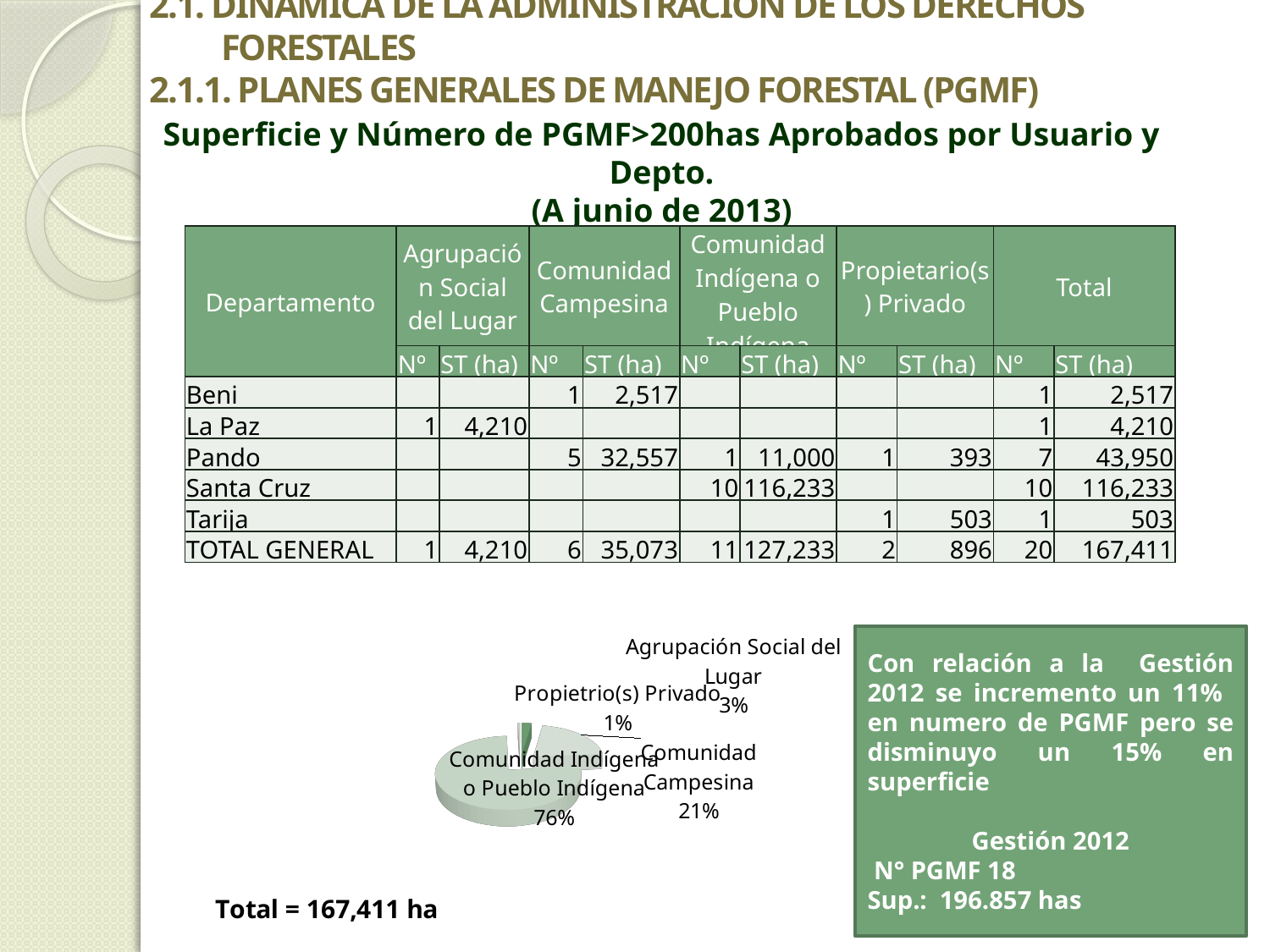
What kind of chart is shown at the bottom of the slide? pie chart In the pie chart, what share does Propietrio(s) Privado have? 1% Is the share for Comunidad Campesina greater or less than 50%? less In the pie chart, which is larger: Comunidad Campesina or Agrupación Social del Lugar? Comunidad Campesina How many slices does the pie chart have? 4 What is the difference in percentage points between the Comunidad Indígena o Pueblo Indígena slice and the Comunidad Campesina slice? 55 percentage points In the pie chart, what share does Comunidad Indígena o Pueblo Indígena have? 76% Which slice of the pie chart is the smallest? Propietrio(s) Privado What total area in hectares is stated below the pie chart? 167,411 ha In the pie chart, what share does Comunidad Campesina have? 21% Which slice of the pie chart is the largest? Comunidad Indígena o Pueblo Indígena